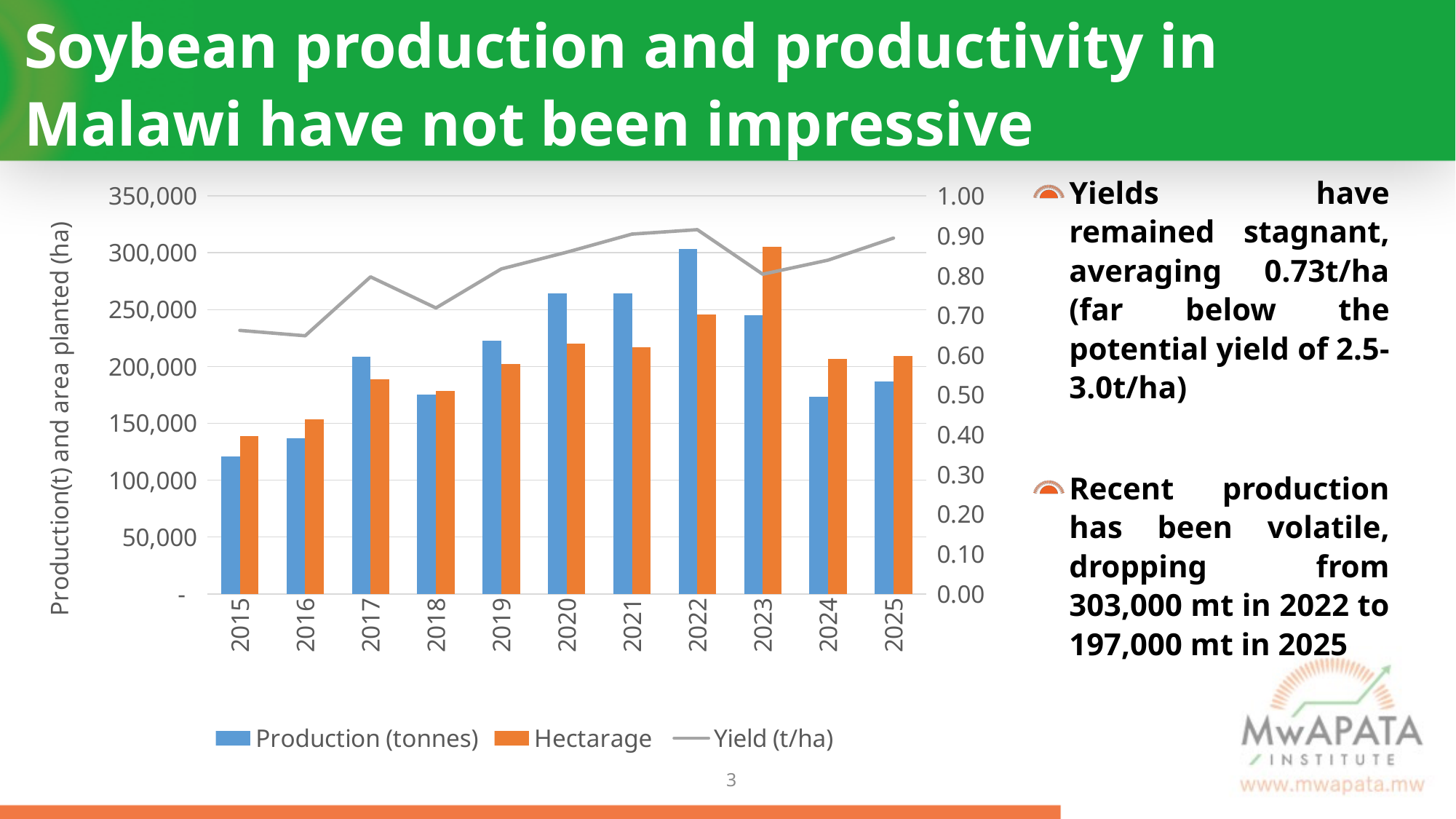
In 2023, which is larger: Production (tonnes) or Hectarage? Hectarage In which year is Production (tonnes) highest? 2022 Does Production (tonnes) rise or fall from 2022 to 2024? fall In which year is Production (tonnes) lowest? 2015 What is the label of the left vertical axis? Production(t) and area planted (ha) Is the Yield (t/ha) value for 2018 greater or less than 0.80? less In which year is Hectarage highest? 2023 What kind of chart is shown on the slide? A bar chart combined with a line Is the Production (tonnes) value for 2022 greater or less than 250,000? greater Is the Production (tonnes) value for 2015 greater or less than 150,000? less How many series does the chart legend list? 3 How many years are shown on the x axis of the chart? 11